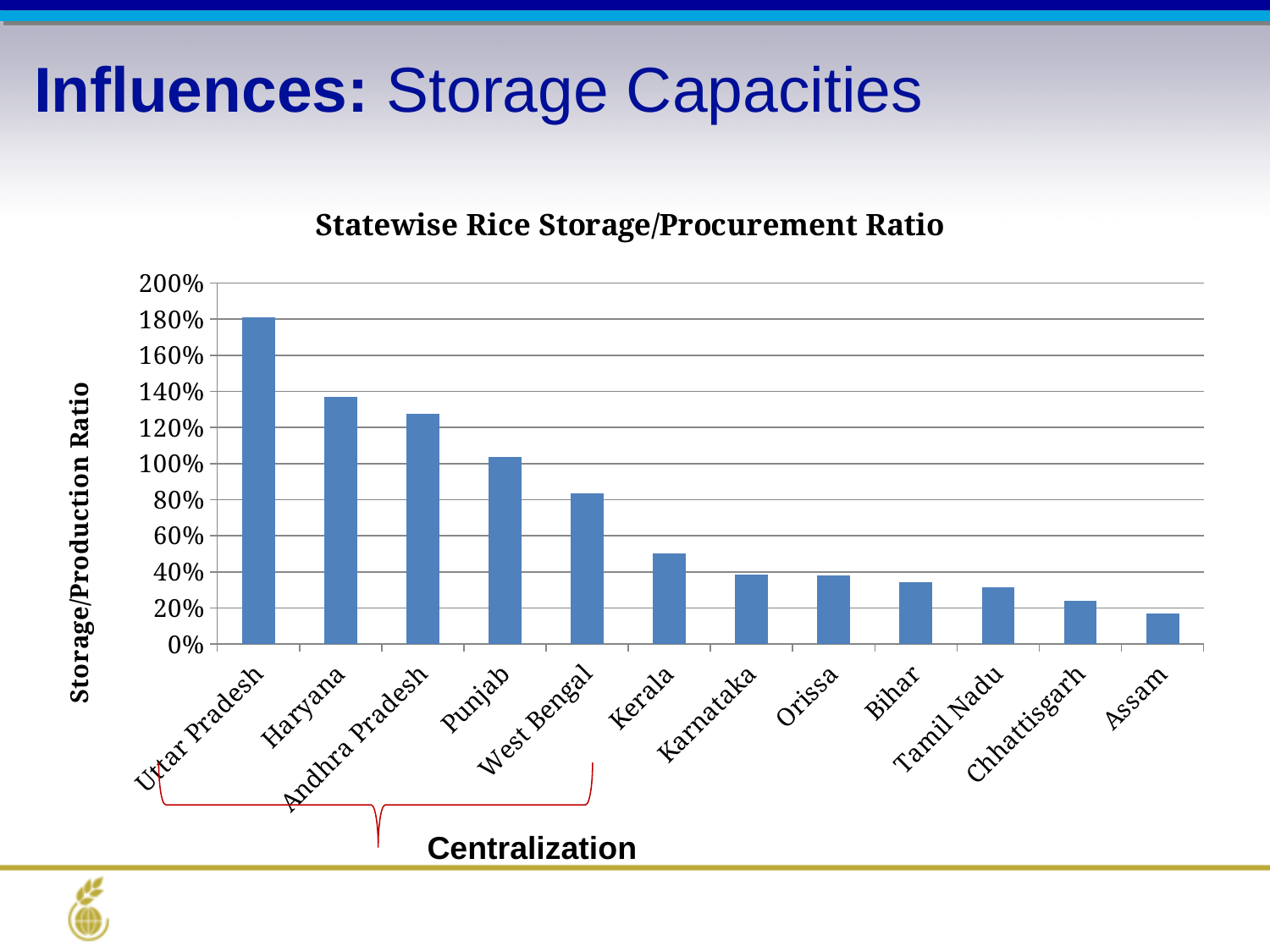
Is the value for Haryana greater or less than 120%? greater Do the values rise or fall moving from left to right along the x axis? Fall How many states are shown on the x axis of the chart? 12 Is the value for Assam greater or less than 20%? less Which has a larger storage/production ratio, Punjab or West Bengal? Punjab Which state has the highest storage/production ratio? Uttar Pradesh What is the title of the chart? Statewise Rice Storage/Procurement Ratio Is the value for West Bengal greater or less than 100%? less What is the label on the vertical axis of the chart? Storage/Production Ratio What kind of chart is shown on the slide? Bar chart Which state has the lowest storage/production ratio? Assam